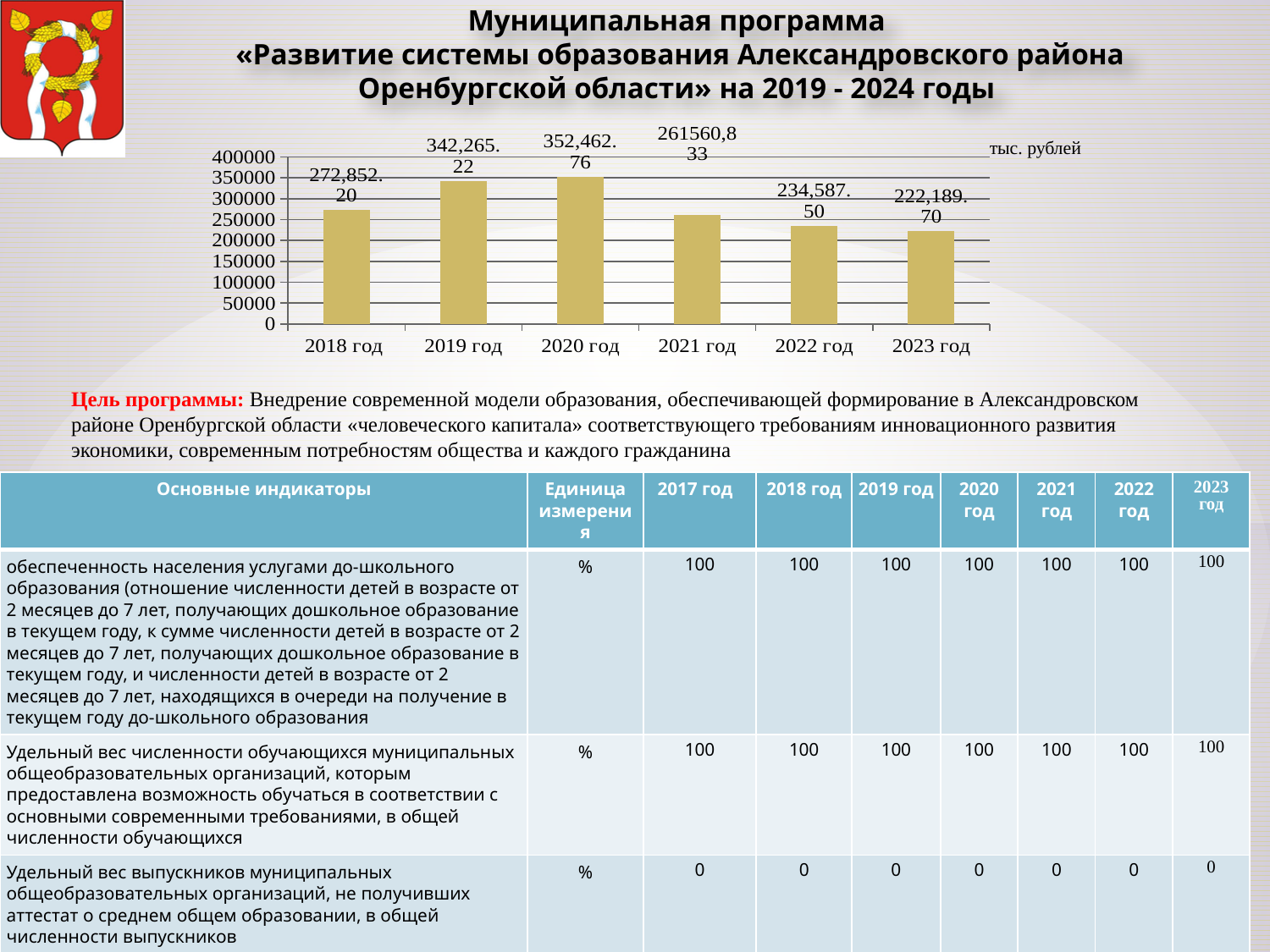
Do the values in the bar chart rise or fall from 2020 год to 2023 год? fall Is the value for 2021 год in the bar chart greater or less than 250000? greater What is the value for 2020 год in the bar chart? 352,462.76 Which year has the lowest value in the bar chart? 2023 год How many years are shown on the x axis of the bar chart? 6 What kind of chart is shown on the slide? bar chart Which is larger in the bar chart, the value for 2019 год or for 2021 год? 2019 год What is the value for 2019 год in the bar chart? 342,265.22 What is the value for 2022 год in the bar chart? 234,587.50 What is the value for 2023 год in the bar chart? 222,189.70 What is the value for 2018 год in the bar chart? 272,852.20 Which year has the highest value in the bar chart? 2020 год